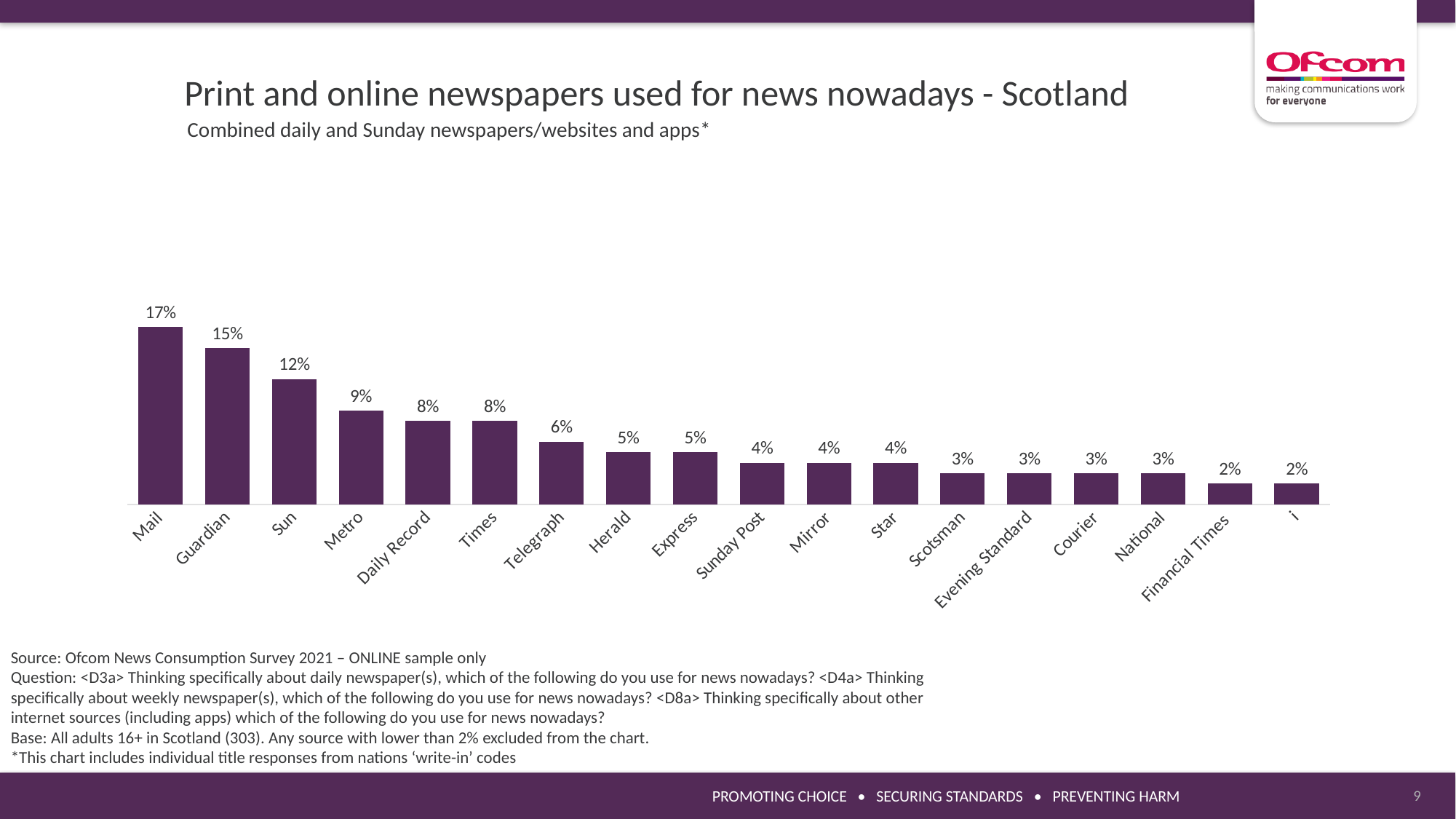
What is the title of the chart? Print and online newspapers used for news nowadays - Scotland What is the difference between the values for Guardian and Sun? 3% Do the values rise or fall from left to right along the x axis? Fall Which newspaper has the highest value? Mail What is the value for Scotsman? 3% What is the value for Daily Record? 8% How many newspapers are shown on the chart? 18 What kind of chart is shown on the slide? Bar chart Which is larger, the value for Metro or the value for Telegraph? Metro What is the value for Mail? 17% What is the difference between the values for Mail and Financial Times? 15% What is the value for Sunday Post? 4%